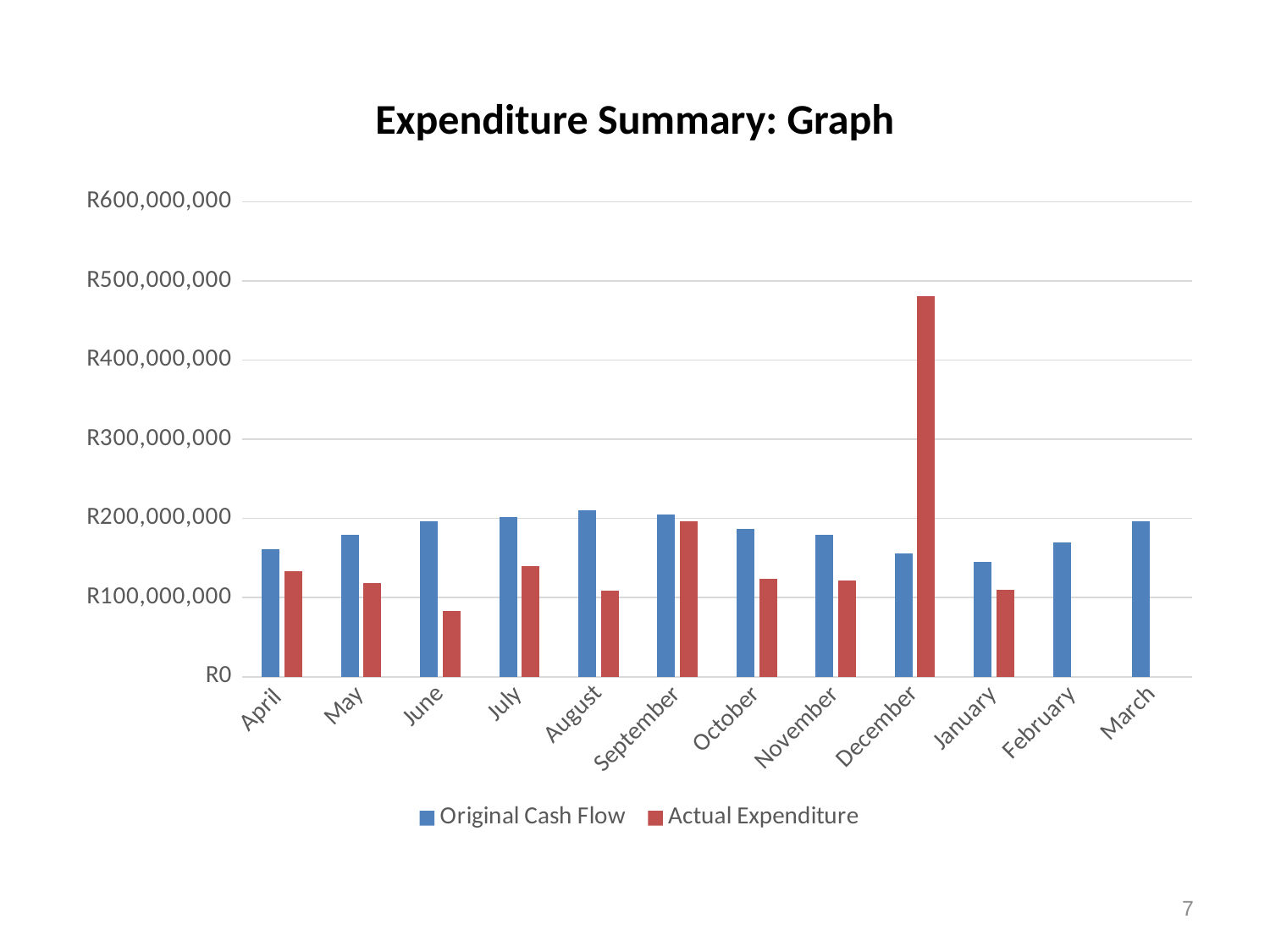
Is the Actual Expenditure for June greater or less than R100,000,000? less Is the Original Cash Flow for January greater or less than R200,000,000? less In June, which is larger: Original Cash Flow or Actual Expenditure? Original Cash Flow How many months are shown on the x axis? 12 Is the Original Cash Flow for August greater or less than R200,000,000? greater Which month has the lowest Actual Expenditure among the months where it is plotted? June What kind of chart is shown on the slide? bar chart In December, which is larger: Original Cash Flow or Actual Expenditure? Actual Expenditure What colour represents Actual Expenditure in the legend? red How many series does the legend list? 2 Which month has the highest Actual Expenditure? December